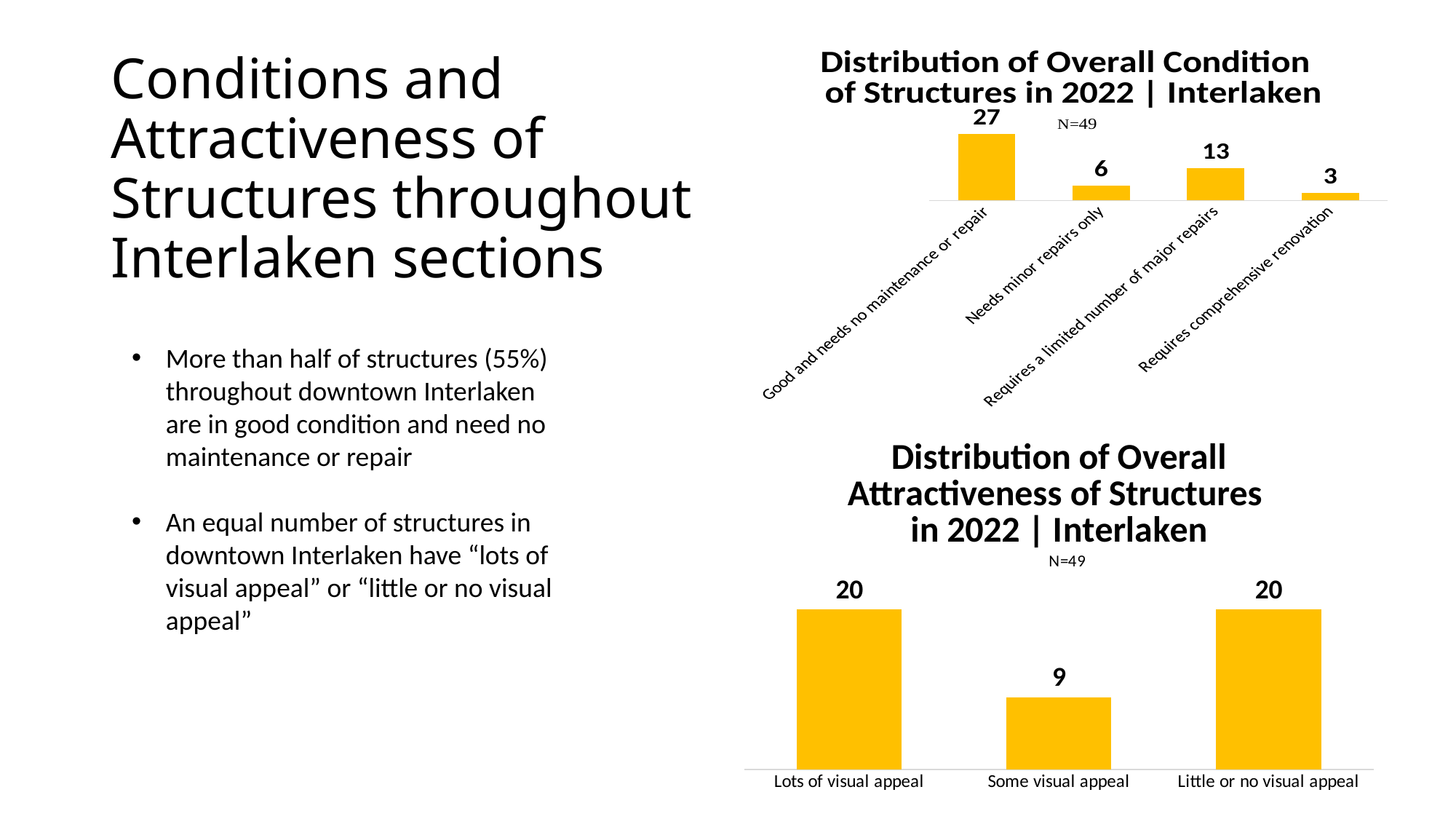
What kind of chart is the 'Distribution of Overall Attractiveness of Structures in 2022 | Interlaken' chart? Bar chart In the 'Distribution of Overall Condition of Structures in 2022 | Interlaken' chart, what is the value for 'Requires a limited number of major repairs'? 13 In the 'Distribution of Overall Attractiveness of Structures in 2022 | Interlaken' chart, what is the value for 'Some visual appeal'? 9 In the 'Distribution of Overall Condition of Structures in 2022 | Interlaken' chart, which category has the highest value? Good and needs no maintenance or repair In the 'Distribution of Overall Attractiveness of Structures in 2022 | Interlaken' chart, what is the value for 'Little or no visual appeal'? 20 In the 'Distribution of Overall Condition of Structures in 2022 | Interlaken' chart, which category has the lowest value? Requires comprehensive renovation In the 'Distribution of Overall Condition of Structures in 2022 | Interlaken' chart, what is the value for 'Good and needs no maintenance or repair'? 27 In the 'Distribution of Overall Attractiveness of Structures in 2022 | Interlaken' chart, which category has the lowest value? Some visual appeal In the 'Distribution of Overall Condition of Structures in 2022 | Interlaken' chart, what is the difference between 'Good and needs no maintenance or repair' and 'Needs minor repairs only'? 21 In the 'Distribution of Overall Attractiveness of Structures in 2022 | Interlaken' chart, what is the difference between 'Lots of visual appeal' and 'Some visual appeal'? 11 In the 'Distribution of Overall Condition of Structures in 2022 | Interlaken' chart, how many categories are shown? 4 In the 'Distribution of Overall Attractiveness of Structures in 2022 | Interlaken' chart, which is larger: 'Lots of visual appeal' or 'Some visual appeal'? Lots of visual appeal